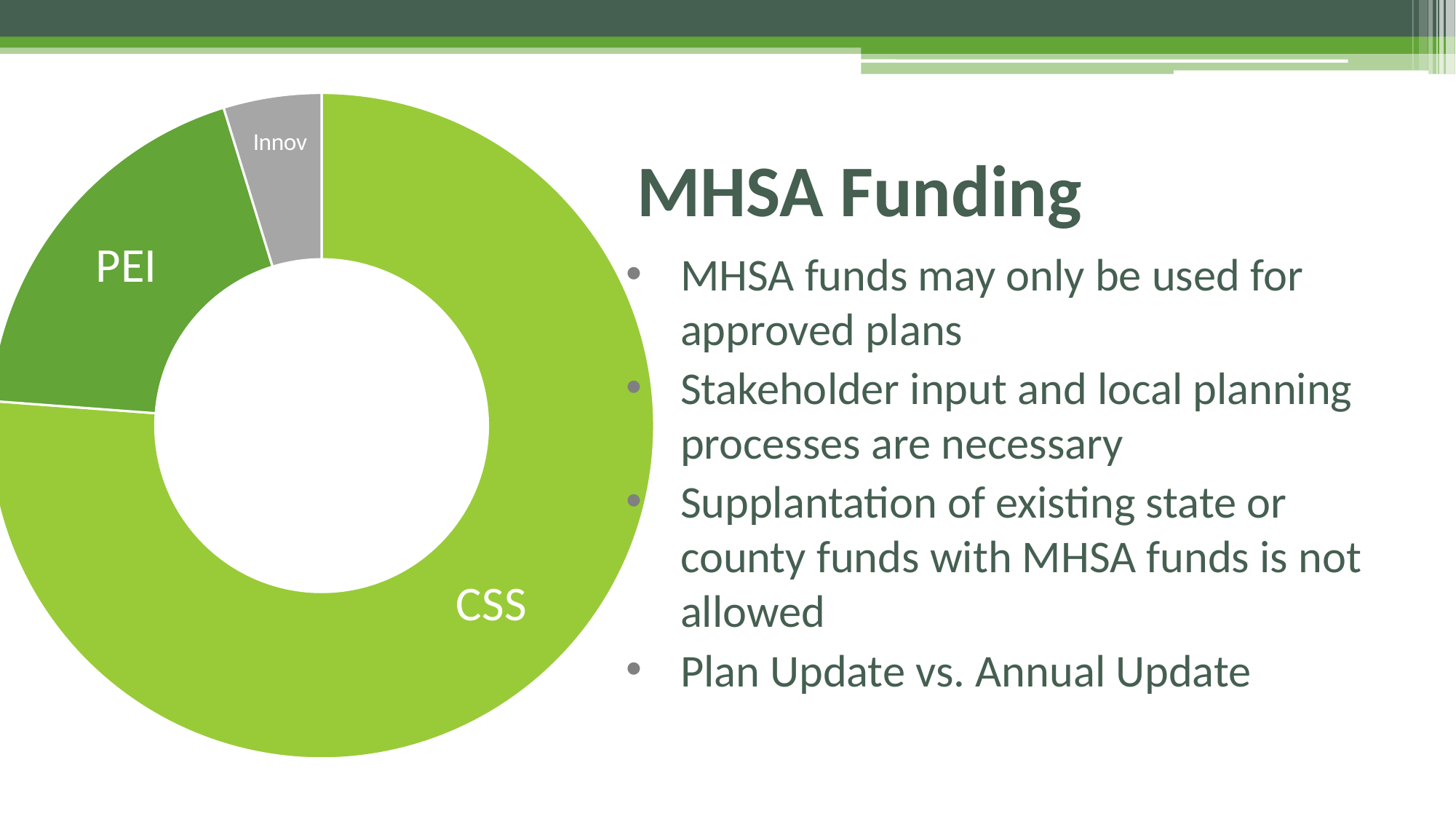
Does the CSS segment take up more or less than half of the doughnut chart? more What colour is the Innov segment of the doughnut chart? grey Which segment of the doughnut chart is the smallest? Innov How many segments does the doughnut chart have? 3 Which segment is larger, CSS or PEI? CSS Which segment is larger, PEI or Innov? PEI Which segment of the doughnut chart is the largest? CSS What kind of chart is shown on the slide? doughnut chart What are the labels of the three segments in the doughnut chart? CSS, PEI, Innov